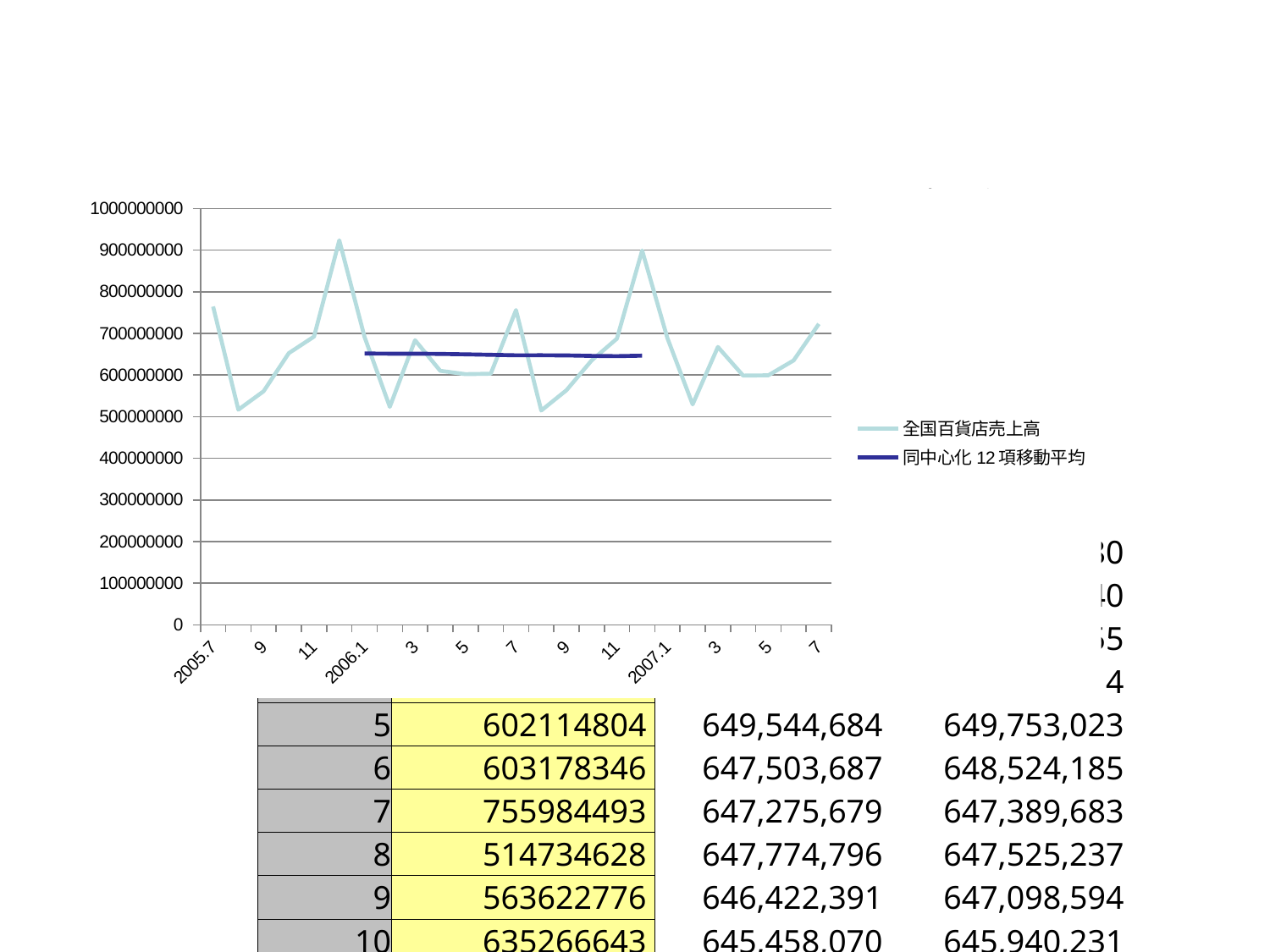
Is the value of 全国百貨店売上高 at 2005.12 greater or less than 800000000? greater How many series does the chart legend list? 2 Is the value of 全国百貨店売上高 at 2007.3 greater or less than 600000000? greater Which is larger: the 全国百貨店売上高 value at 2005.12 or at 2006.12? 2005.12 What is the highest value shown on the chart's vertical axis? 1000000000 What are the two series named in the chart legend? 全国百貨店売上高 and 同中心化12項移動平均 Is the 同中心化12項移動平均 series greater or less than 700000000 throughout the period it is plotted? less Does the 同中心化12項移動平均 line rise or fall from 2006.1 to 2006.12? falls At which x-axis point does the 全国百貨店売上高 series reach its highest value? 2005.12 What kind of chart is shown on the slide? line chart